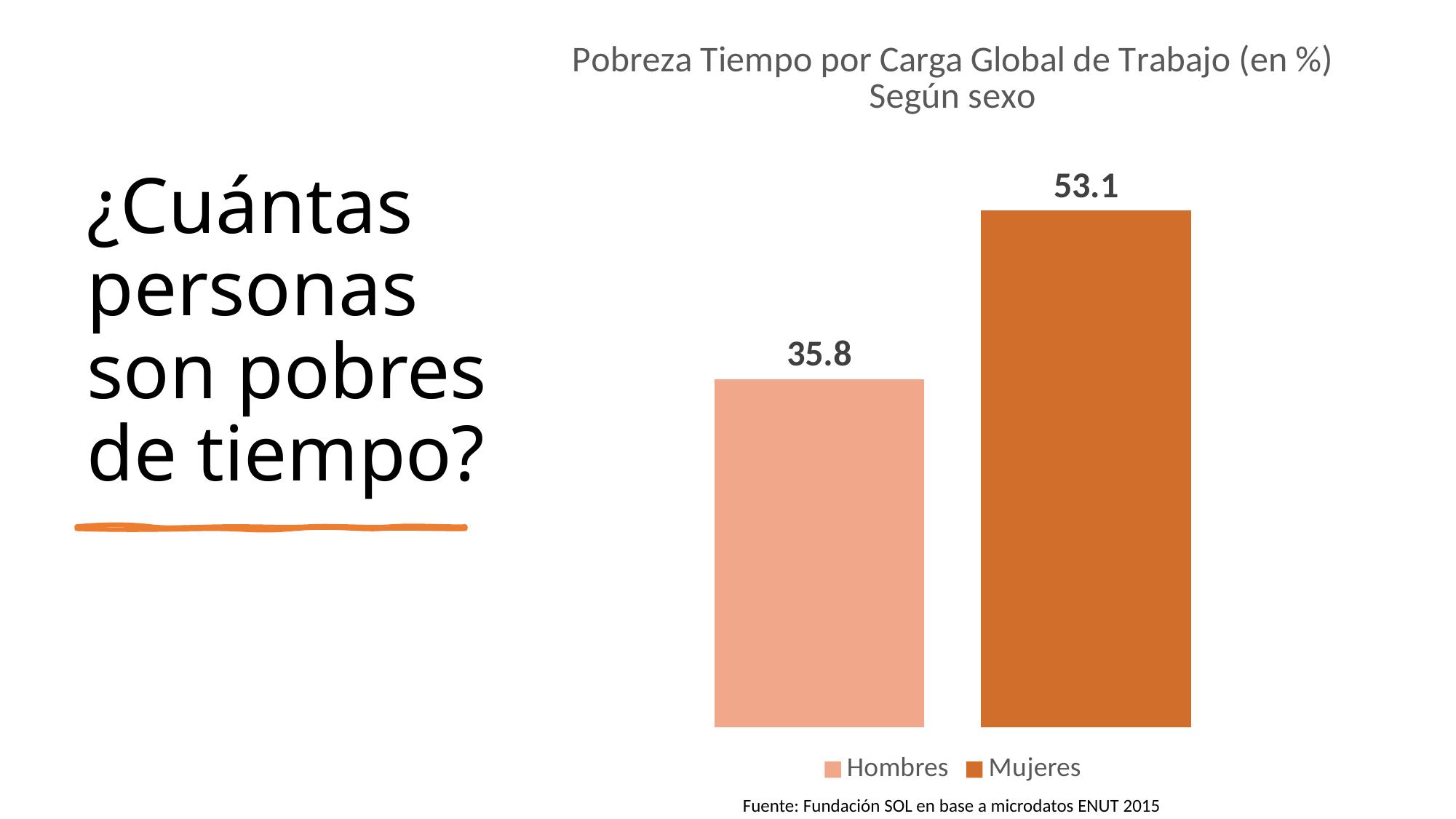
What is the difference between the values for Mujeres and Hombres? 17.3 How many bars are plotted in the chart? 2 What is the value for Mujeres? 53.1 How many series does the legend list? 2 Is the value for Hombres larger or smaller than the value for Mujeres? smaller What is the value for Hombres? 35.8 What is the title of the chart? Pobreza Tiempo por Carga Global de Trabajo (en %) Según sexo Which legend entry is shown in the darker orange colour? Mujeres Which group has the lower value? Hombres Which group has the higher value, Hombres or Mujeres? Mujeres What kind of chart is shown on the slide? bar chart